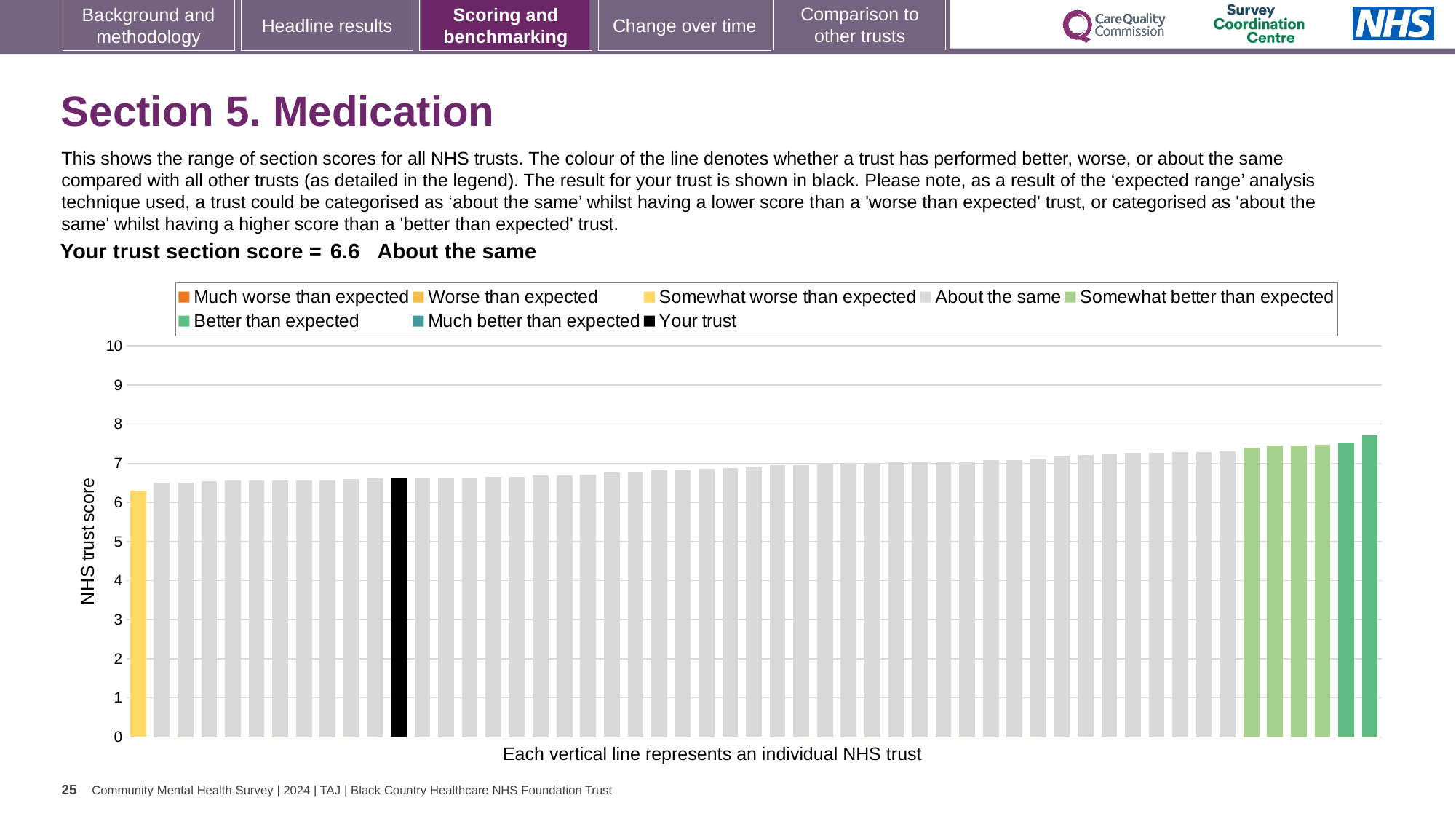
What is the trust's section score for Section 5. Medication? 6.6 Is the value of the black 'Your trust' bar greater or less than 5? greater Is the leftmost bar larger or smaller than the black 'Your trust' bar? smaller What kind of chart is shown on the slide? bar chart How many entries does the chart legend list? 8 What colour is the bar representing your trust? black Which performance category is the trust's section score placed in? About the same Do the bar values rise or fall from left to right along the x axis? rise What is the label on the vertical axis of the chart? NHS trust score Is the value of the tallest bar greater or less than 8? less Which legend category does the tallest bar belong to? Better than expected Is the value of the leftmost (yellow) bar greater or less than 6? greater